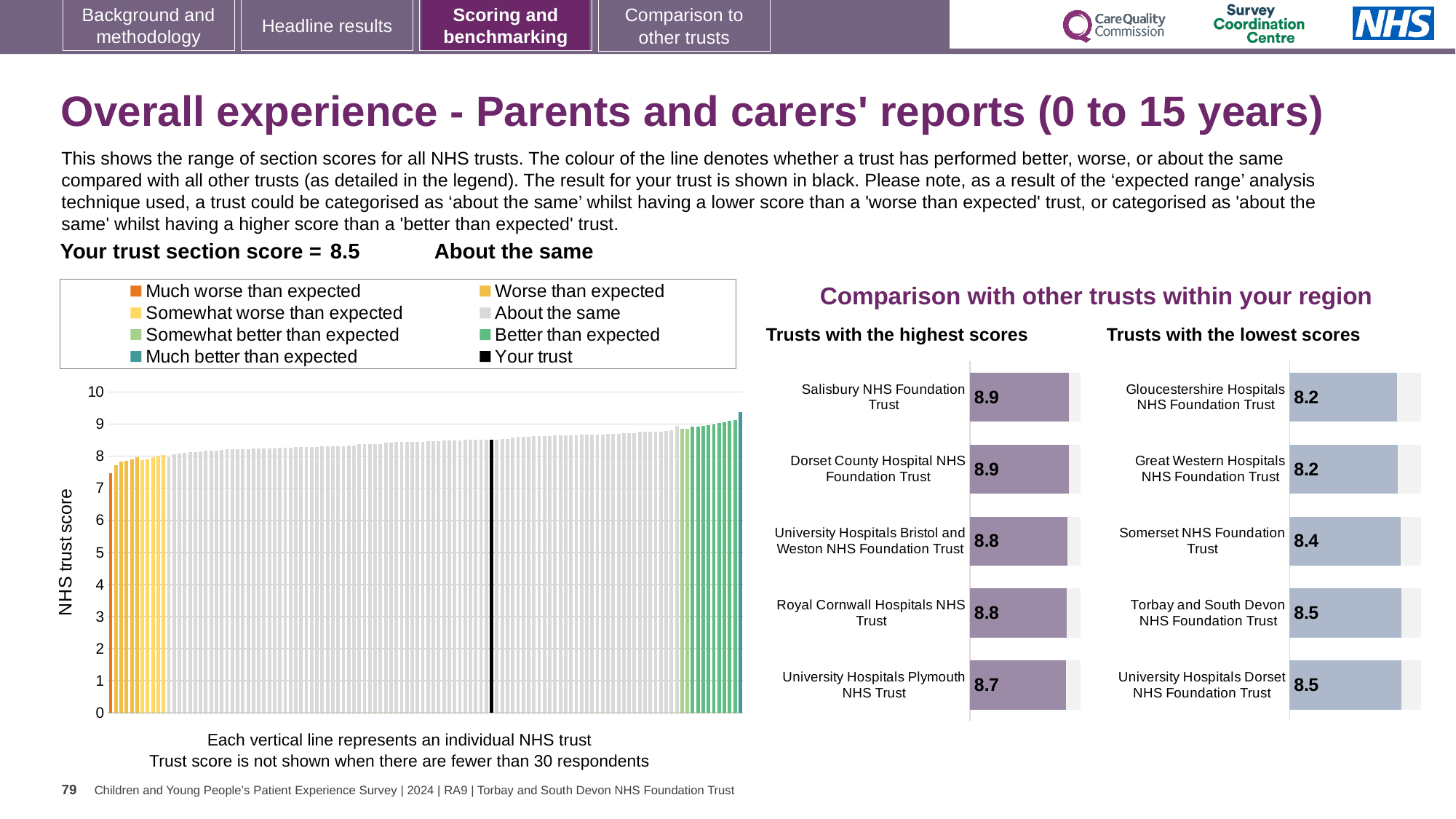
In the 'Trusts with the highest scores' chart, which trust has the lowest score? University Hospitals Plymouth NHS Trust How many trusts are listed in the 'Trusts with the lowest scores' chart? 5 In the 'Trusts with the highest scores' chart, what is the score for University Hospitals Plymouth NHS Trust? 8.7 What is the y-axis label of the large chart on the left? NHS trust score What kind of chart is the large chart on the left of the slide? Bar chart In the 'Trusts with the lowest scores' chart, what is the score for Somerset NHS Foundation Trust? 8.4 In the large chart on the left, is the value for the leftmost (orange) bar greater or less than 8? less In the 'Trusts with the highest scores' chart, what is the difference between the scores of Salisbury NHS Foundation Trust and University Hospitals Plymouth NHS Trust? 0.2 In the 'Trusts with the highest scores' chart, what is the score for Salisbury NHS Foundation Trust? 8.9 In the 'Trusts with the lowest scores' chart, what is the score for Gloucestershire Hospitals NHS Foundation Trust? 8.2 In the large chart on the left, is the value for the black 'Your trust' bar greater or less than 8? greater In the 'Trusts with the lowest scores' chart, which has the larger score: Somerset NHS Foundation Trust or Great Western Hospitals NHS Foundation Trust? Somerset NHS Foundation Trust